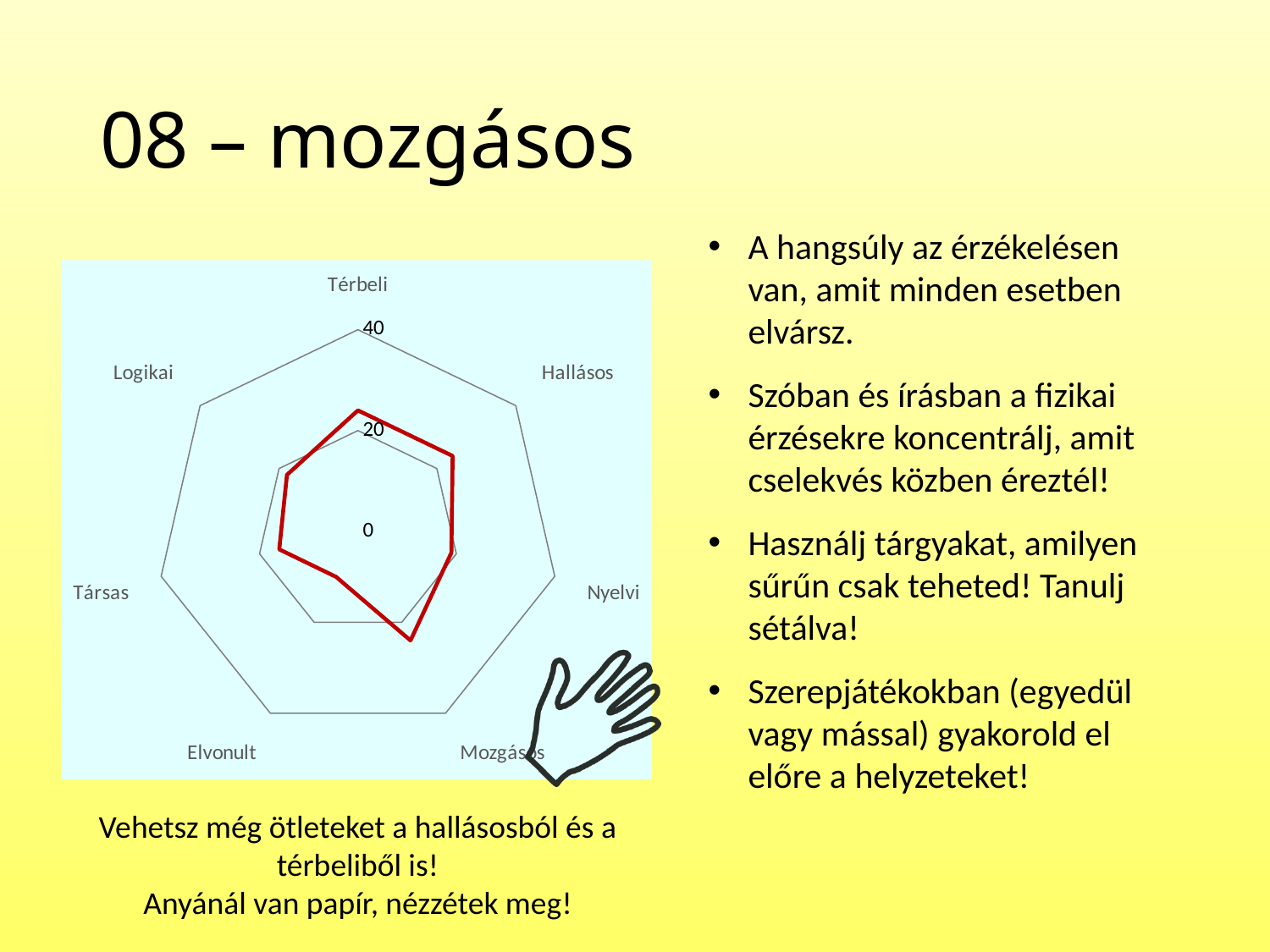
What is the highest tick value shown on the radar chart's axis? 40 Which category is at the top of the radar chart? Térbeli Is the value for Társas greater or less than 20? less Which is larger, the value for Hallásos or the value for Társas? Hallásos How many categories (axes) does the radar chart have? 7 Is the value for Mozgásos greater or less than 40? less Is the value for Elvonult greater or less than 20? less What kind of chart is shown on the slide? radar chart Which is larger, the value for Mozgásos or the value for Elvonult? Mozgásos